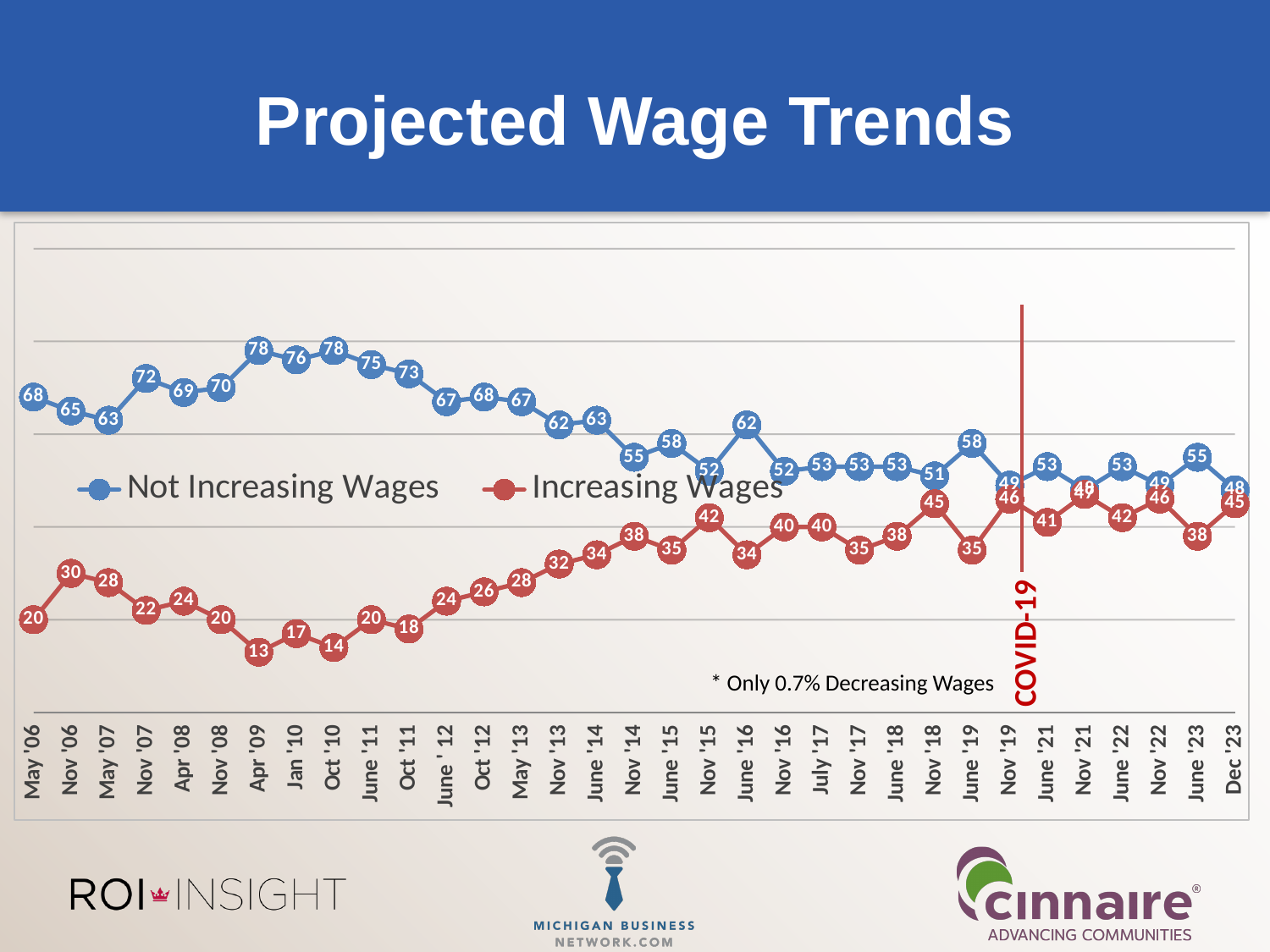
What is the highest value reached by the Not Increasing Wages series? 78 What is the value for Not Increasing Wages in May '06? 68 What kind of chart is shown on the slide? Line chart In June '23, which series has the larger value, Not Increasing Wages or Increasing Wages? Not Increasing Wages How many series does the legend list? 2 What is the difference between Not Increasing Wages and Increasing Wages in May '06? 48 What is the value for Increasing Wages in Dec '23? 45 In which period does the Increasing Wages series reach its lowest value? Apr '09 What is the value for Increasing Wages in Apr '09? 13 What is the value for Not Increasing Wages in June '16? 62 Does the Increasing Wages series rise or fall between Apr '09 and Nov '14? Rise What event is marked by the vertical red line on the chart? COVID-19